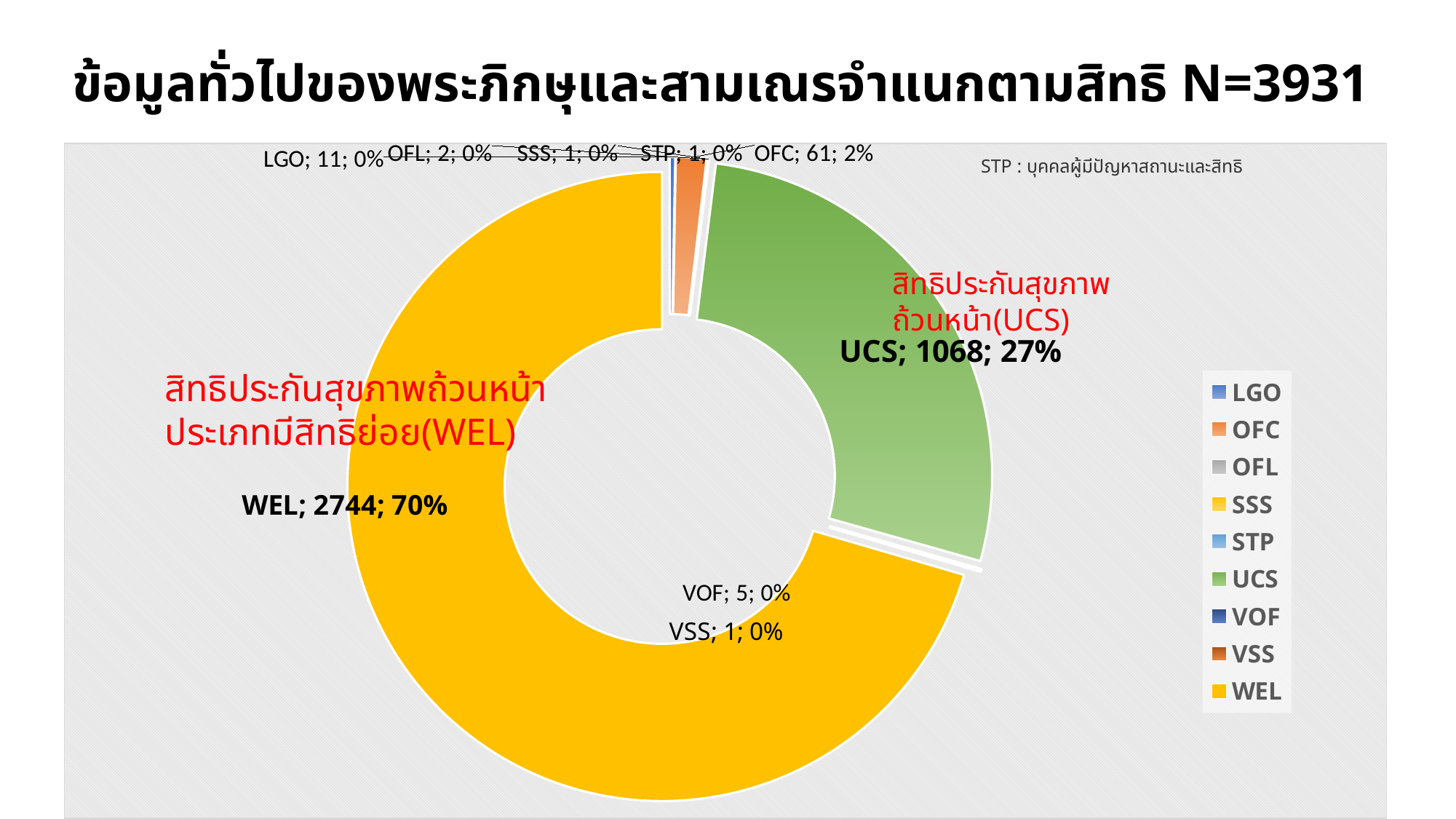
What is the value for LGO? 11 What is the difference between the values for WEL and UCS? 1676 What colour represents UCS in the chart? Green What percentage share does WEL have? 70% Which is larger, the value for OFC or the value for LGO? OFC What is the value for WEL? 2744 Which category has the largest value? WEL How many entries does the legend list? 9 What is the value for UCS? 1068 What is the value for OFC? 61 What percentage share does UCS have? 27% What kind of chart is shown on the slide? Doughnut (pie) chart